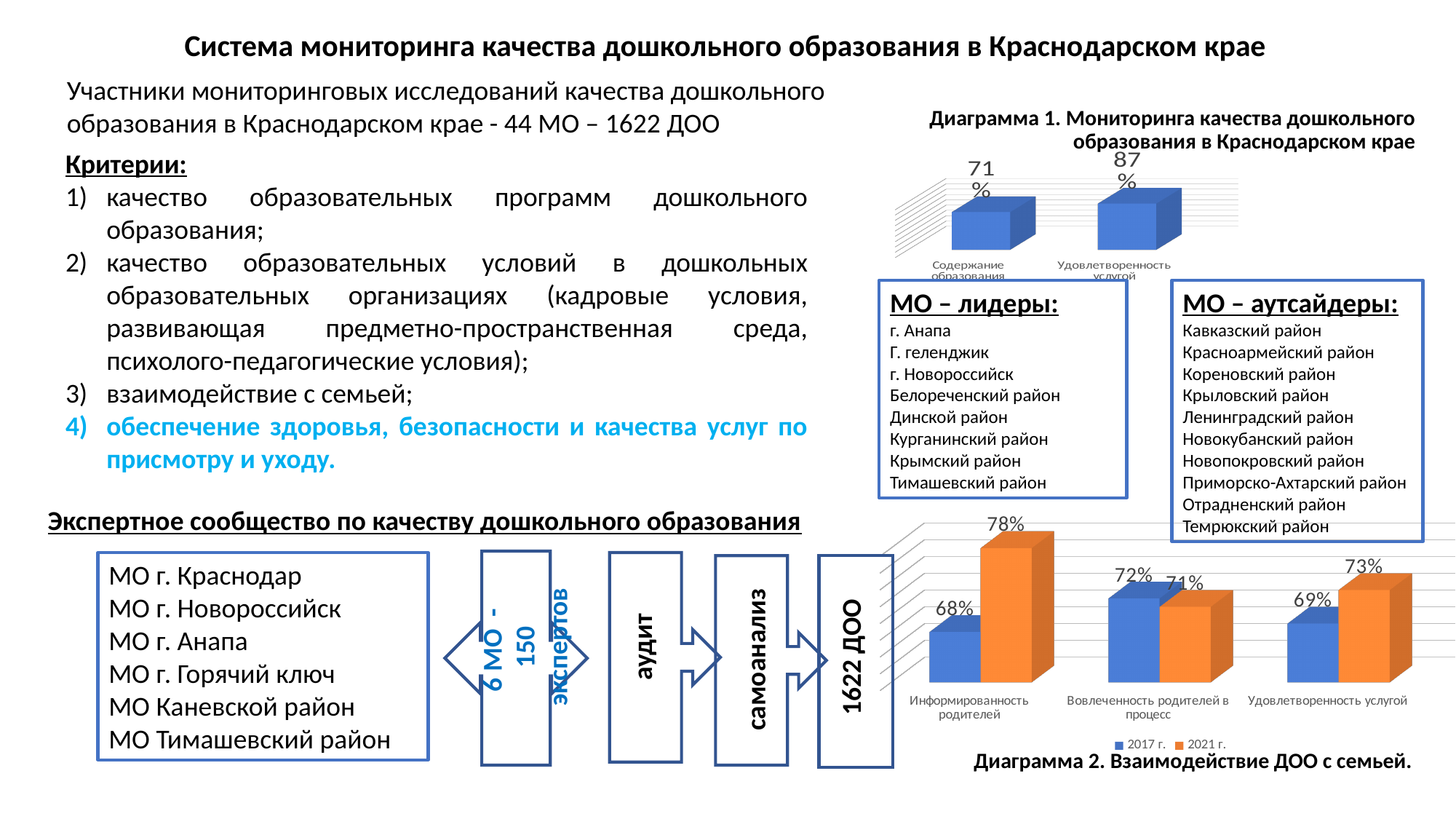
In Диаграмма 1 (top right), what is the value for Удовлетворенность услугой? 87% In Диаграмма 1 (top right), which category has the higher value? Удовлетворенность услугой In Диаграмма 2 (bottom right), what is the 2021 г. value for Информированность родителей? 78% In Диаграмма 2 (bottom right), what is the 2017 г. value for Удовлетворенность услугой? 69% In Диаграмма 2 (bottom right), which is larger for Удовлетворенность услугой: the 2017 г. value or the 2021 г. value? 2021 г. What type of chart is Диаграмма 2 (bottom right)? Bar chart In Диаграмма 1 (top right), how many categories are shown? 2 In Диаграмма 2 (bottom right), what is the difference between the 2021 г. and 2017 г. values for Информированность родителей? 10% In Диаграмма 2 (bottom right), how many series does the legend list? 2 In Диаграмма 1 (top right), what is the difference between Удовлетворенность услугой and Содержание образования? 16% In Диаграмма 1 (top right), what is the value for Содержание образования? 71% In Диаграмма 2 (bottom right), what is the 2017 г. value for Вовлеченность родителей в процесс? 72%